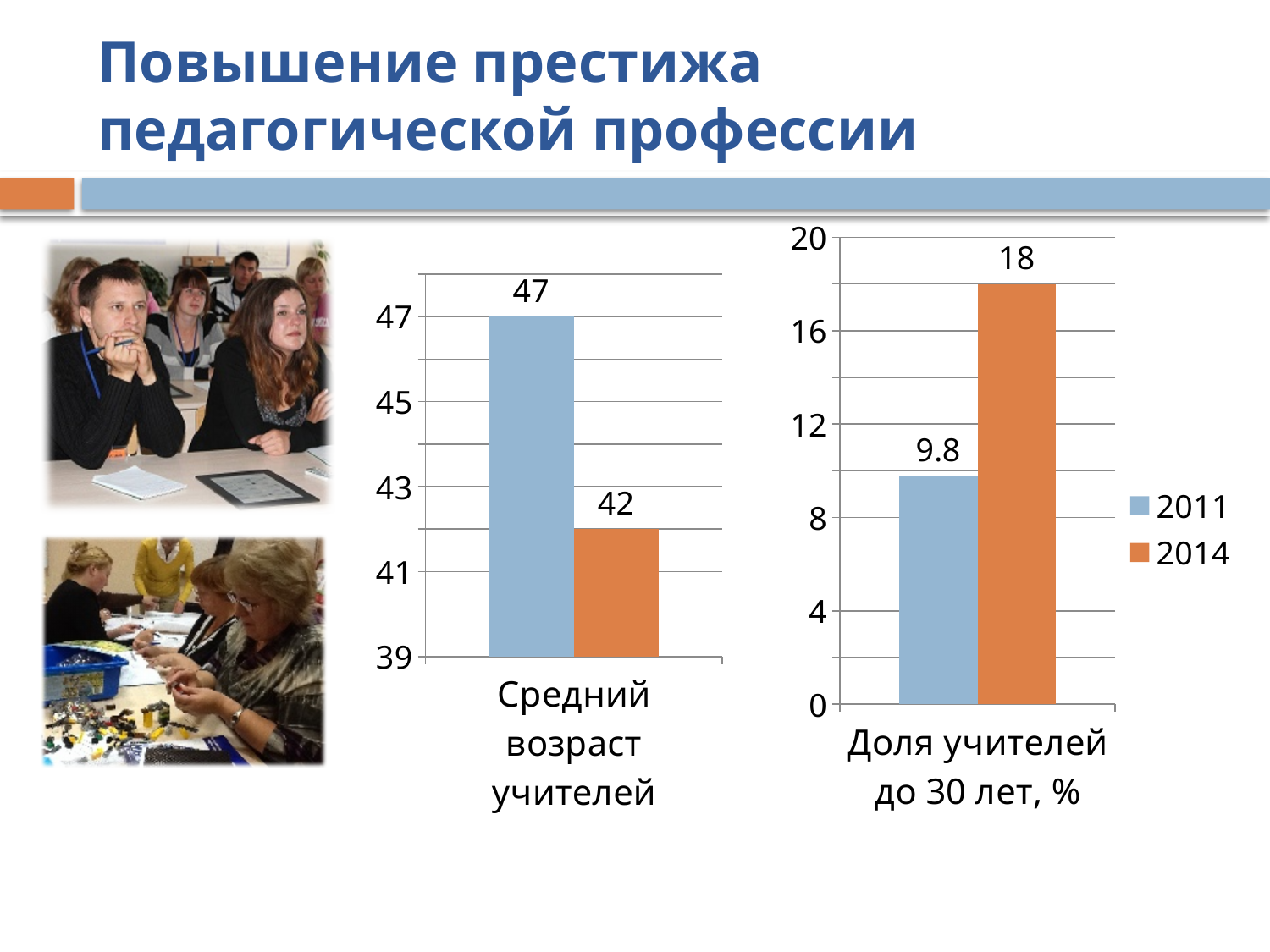
What kind of chart is the right chart (Доля учителей до 30 лет, %)? bar chart In the left chart (Средний возраст учителей), by how much did the value fall from 2011 to 2014? 5 In the right chart (Доля учителей до 30 лет, %), what is the value for 2011? 9.8 In the left chart (Средний возраст учителей), what is the value for 2014? 42 In the right chart (Доля учителей до 30 лет, %), what is the difference between the 2014 and 2011 values? 8.2 In the right chart (Доля учителей до 30 лет, %), is the value for 2011 greater or less than 12? less Which colour represents 2014 in the legend? orange In the left chart (Средний возраст учителей), which year has the lower value? 2014 In the right chart (Доля учителей до 30 лет, %), which year has the higher value, 2011 or 2014? 2014 In the left chart (Средний возраст учителей), what is the value for 2011? 47 How many series does the legend on the right chart list? 2 In the right chart (Доля учителей до 30 лет, %), what is the value for 2014? 18